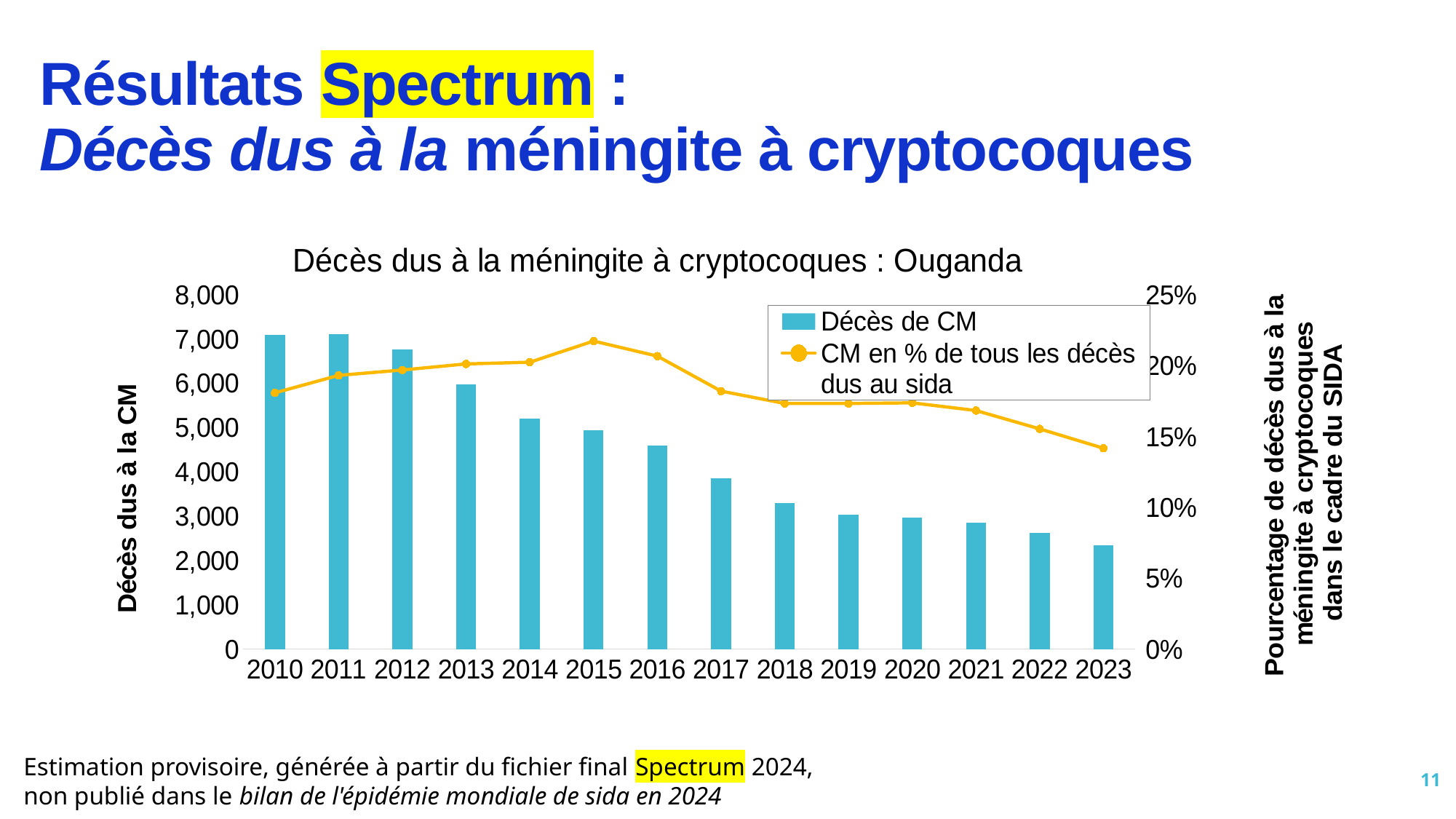
In which year does the line 'CM en % de tous les décès dus au sida' reach its highest value? 2015 How many series does the legend list? 2 Do the CM deaths (bars) rise or fall from 2010 to 2023? fall Is the number of CM deaths in 2014 greater or less than 5,000? greater How many years are shown on the x axis? 14 Which year has the lowest number of CM deaths (Décès de CM)? 2023 Is the value of 'CM en % de tous les décès dus au sida' in 2015 greater or less than 20%? greater In which year is the line 'CM en % de tous les décès dus au sida' at its lowest value? 2023 Which year has more CM deaths, 2012 or 2016? 2012 Is the value of 'CM en % de tous les décès dus au sida' in 2023 greater or less than 15%? less What kind of chart is shown on the slide? A combined bar and line chart